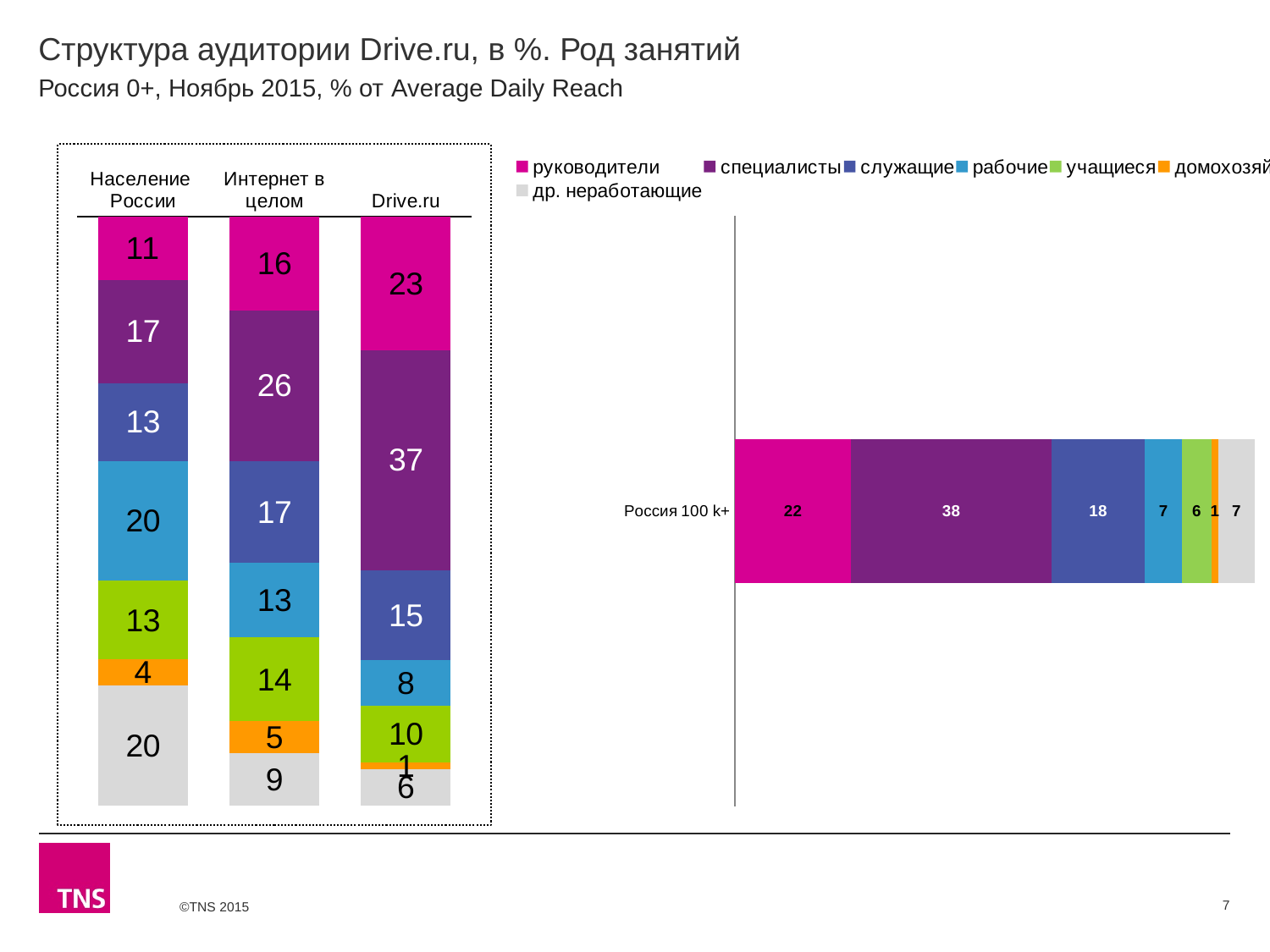
What type of chart is the right chart (Россия 100 k+)? Stacked bar chart In the left chart, what is the value for руководители in the Население России column? 11 In the left chart, which column has the lowest value for др. неработающие? Drive.ru How many series does the legend list? 7 In the left chart, which is larger: рабочие for Население России or рабочие for Drive.ru? Население России How many columns (categories) does the left chart show? 3 In the left chart, what is the value for специалисты in the Drive.ru column? 37 In the right chart (Россия 100 k+), what is the value for служащие? 18 In the right chart (Россия 100 k+), what is the value for специалисты? 38 In the left chart, what is the value for рабочие in the Интернет в целом column? 13 In the left chart, what is the difference between the специалисты values for Drive.ru and Население России? 20 In the left chart, which column has the highest value for руководители? Drive.ru